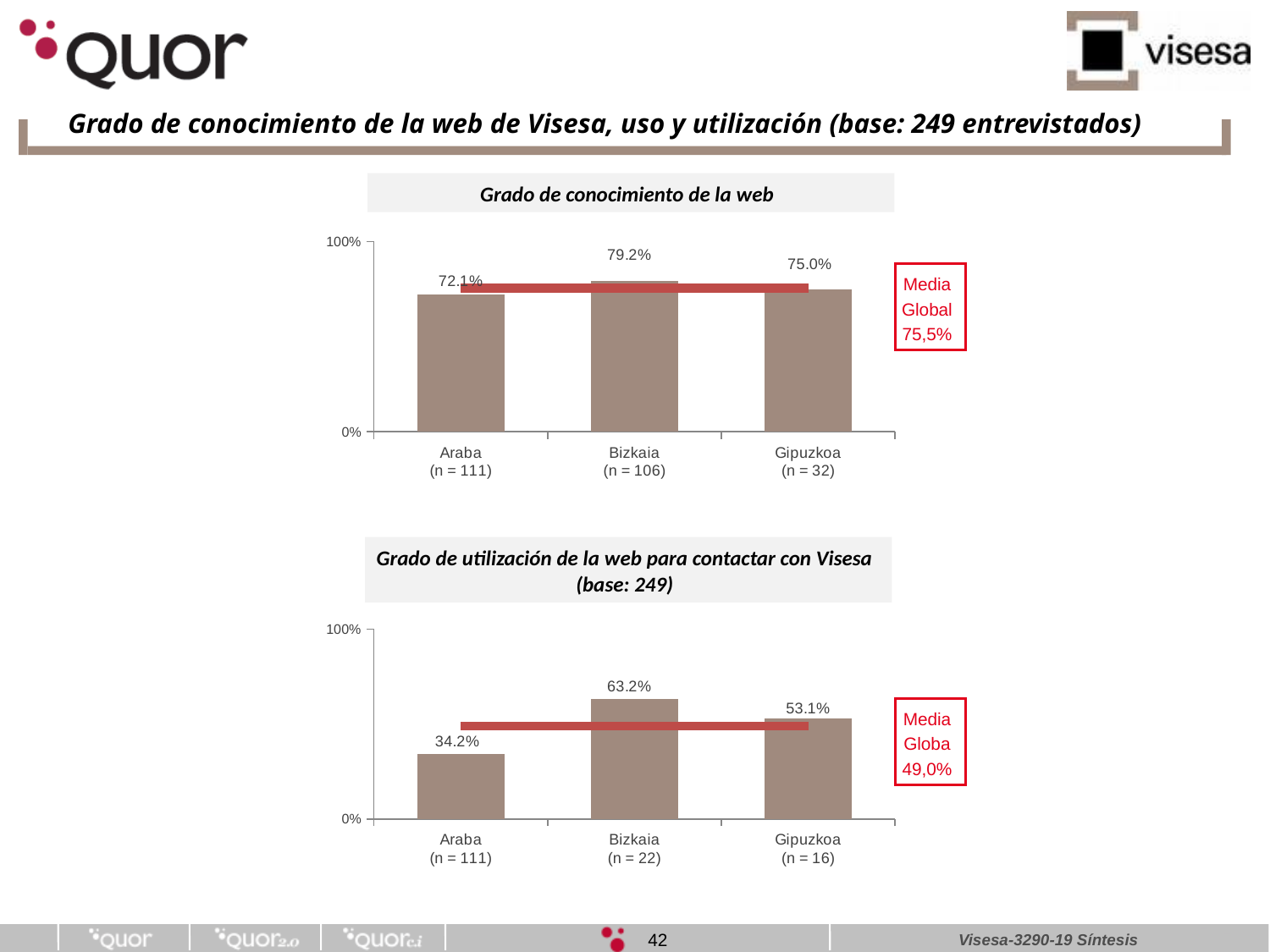
In the chart 'Grado de conocimiento de la web', what is the value for Bizkaia? 79.2% In the chart 'Grado de utilización de la web para contactar con Visesa', which is larger, the value for Bizkaia or the value for Gipuzkoa? Bizkaia In the chart 'Grado de utilización de la web para contactar con Visesa', what is the value for Araba? 34.2% In the chart 'Grado de utilización de la web para contactar con Visesa', what is the value for Gipuzkoa? 53.1% In the chart 'Grado de utilización de la web para contactar con Visesa', which category has the highest value? Bizkaia In the chart 'Grado de conocimiento de la web', which category has the highest value? Bizkaia How many categories are shown in the chart 'Grado de conocimiento de la web'? 3 In the chart 'Grado de conocimiento de la web', which category has the lowest value? Araba In the chart 'Grado de conocimiento de la web', what is the value for Araba? 72.1% What type of chart is the bottom chart on the slide? Bar chart In the chart 'Grado de conocimiento de la web', what is the difference between the values for Bizkaia and Araba? 7.1% In the chart 'Grado de utilización de la web para contactar con Visesa', what is the difference between the values for Bizkaia and Araba? 29.0%